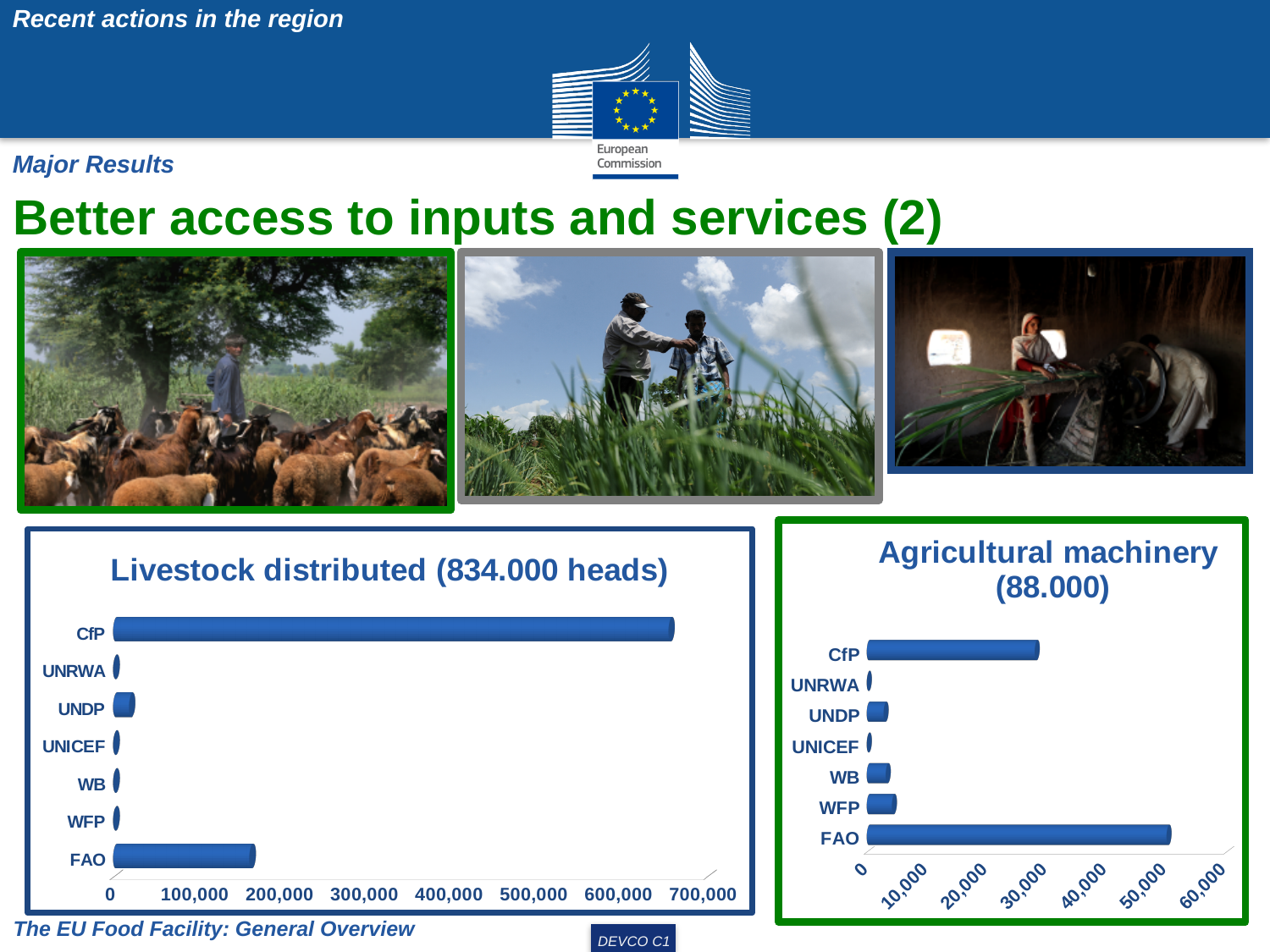
In the 'Livestock distributed (834.000 heads)' chart, is the value for FAO greater or less than 200,000? less In the 'Livestock distributed (834.000 heads)' chart, is the value for CfP greater or less than 600,000? greater In the 'Agricultural machinery (88.000)' chart, which category has the highest value? FAO In the 'Livestock distributed (834.000 heads)' chart, which is larger, the value for CfP or the value for FAO? CfP In the 'Agricultural machinery (88.000)' chart, is the value for FAO greater or less than 40,000? greater How many categories are shown in the 'Livestock distributed (834.000 heads)' chart? 7 In the 'Livestock distributed (834.000 heads)' chart, which category has the highest value? CfP How many categories are shown in the 'Agricultural machinery (88.000)' chart? 7 In the 'Agricultural machinery (88.000)' chart, which is larger, the value for CfP or the value for FAO? FAO What kind of chart is the 'Livestock distributed (834.000 heads)' chart? bar chart